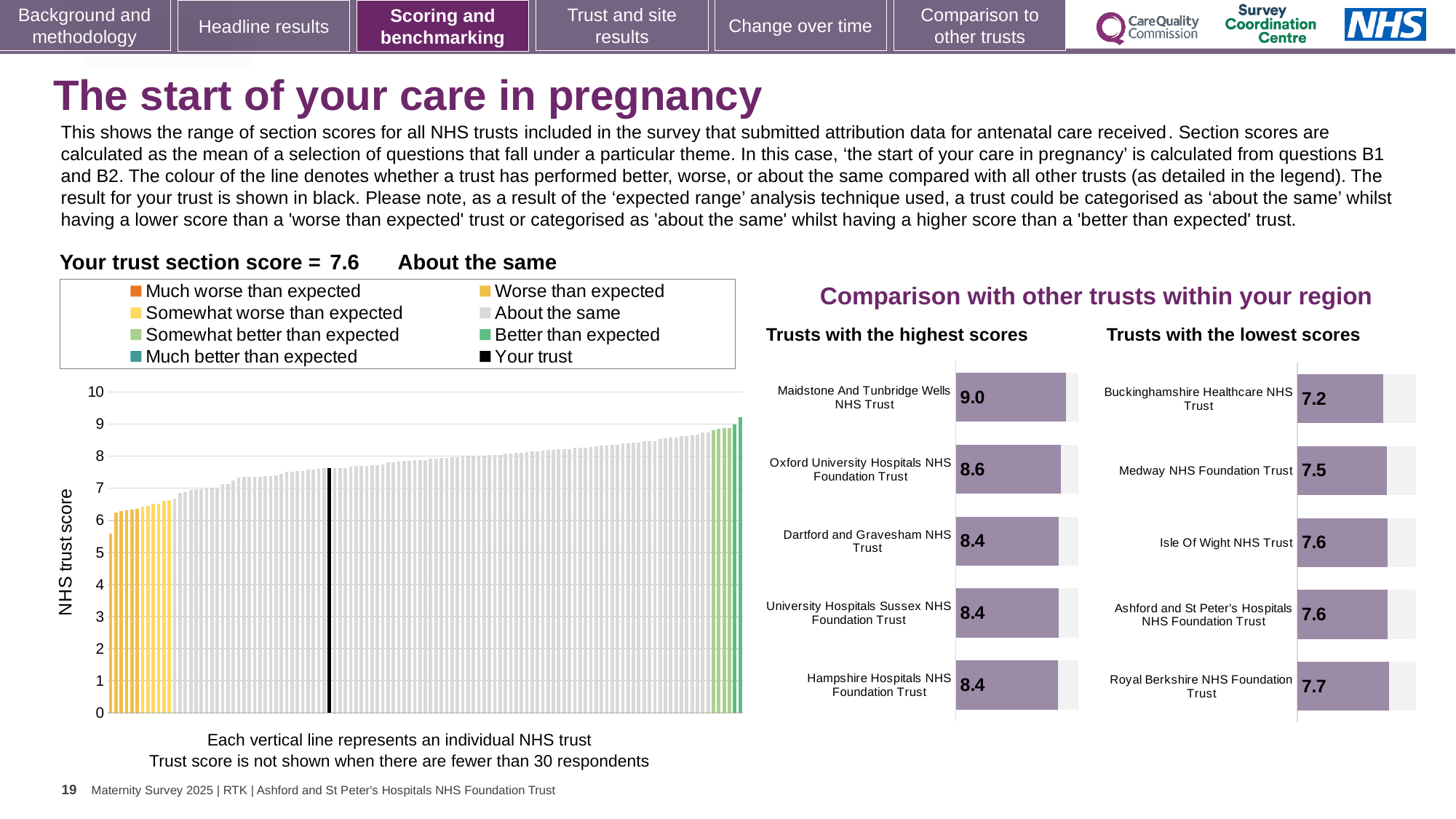
In the 'Trusts with the lowest scores' chart, what is the score for Buckinghamshire Healthcare NHS Trust? 7.2 In the 'Trusts with the highest scores' chart, which trust has the highest score? Maidstone And Tunbridge Wells NHS Trust Which has the higher score: Oxford University Hospitals NHS Foundation Trust in the highest scores chart or Medway NHS Foundation Trust in the lowest scores chart? Oxford University Hospitals NHS Foundation Trust In the 'Trusts with the lowest scores' chart, which trust has the lowest score? Buckinghamshire Healthcare NHS Trust In the main NHS trust score chart on the left, do the trust scores rise or fall from left to right? Rise In the 'Trusts with the lowest scores' chart, how much higher is Royal Berkshire NHS Foundation Trust's score than Buckinghamshire Healthcare NHS Trust's score? 0.5 In the main NHS trust score chart on the left, what is the section score for your trust? 7.6 What kind of chart is the main NHS trust score chart on the left? Bar chart In the 'Trusts with the highest scores' chart, what is the score for Maidstone And Tunbridge Wells NHS Trust? 9.0 How many entries does the legend of the main NHS trust score chart on the left list? 8 How many trusts are shown in the 'Trusts with the highest scores' chart? 5 In the 'Trusts with the highest scores' chart, what is the difference between the scores of Maidstone And Tunbridge Wells NHS Trust and Oxford University Hospitals NHS Foundation Trust? 0.4